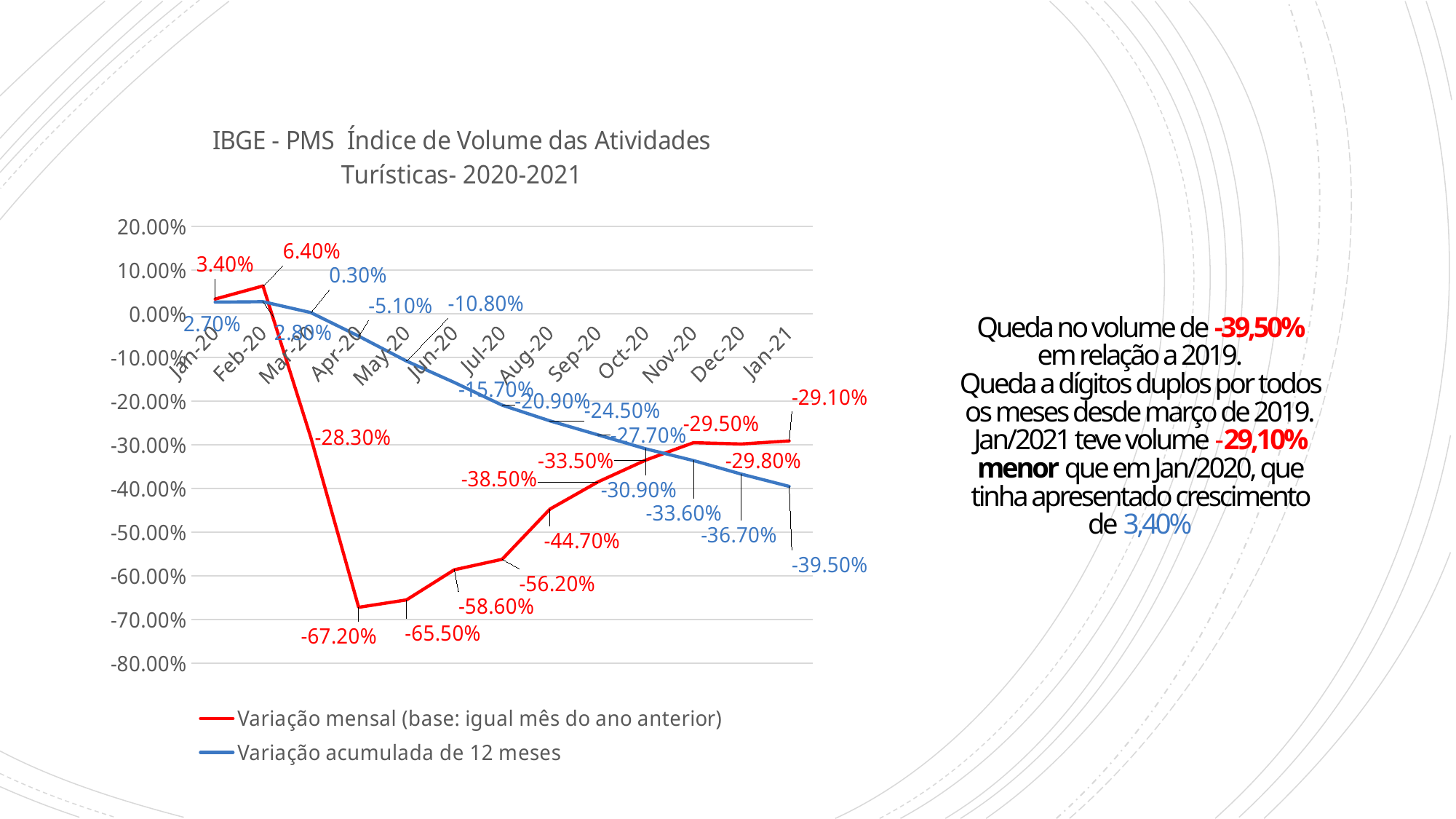
What type of chart is shown on the slide? Line chart What is the value of 'Variação mensal' for Jan-21? -29.10% How many series does the legend list? 2 What is the value of 'Variação acumulada de 12 meses' for Jan-21? -39.50% Does 'Variação acumulada de 12 meses' rise or fall from Mar-20 to Jan-21? Fall What is the value of 'Variação mensal' for Apr-20? -67.20% What is the difference between 'Variação mensal' and 'Variação acumulada de 12 meses' in Jan-21? 10.40 percentage points What is the value of 'Variação mensal' for Feb-20? 6.40% Which series has the lower value in Apr-20, 'Variação mensal' or 'Variação acumulada de 12 meses'? Variação mensal In which month does 'Variação mensal' reach its highest value? Feb-20 In which month does 'Variação mensal' reach its lowest value? Apr-20 How many months are plotted along the x axis? 13